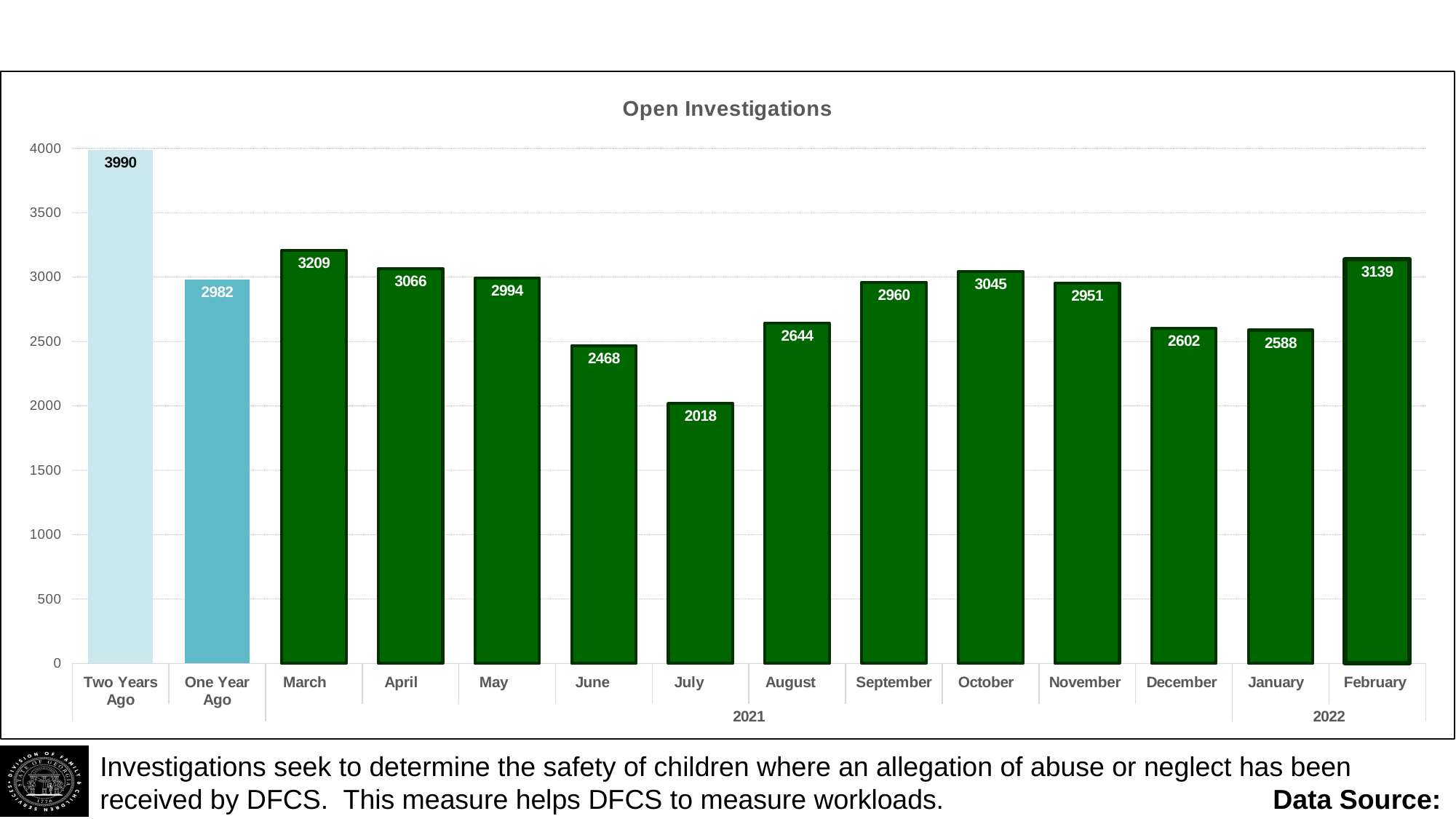
What is the value for February 2022? 3139 What is the title of the chart? Open Investigations Which is larger, the value for October or the value for November? October Which category has the highest value? Two Years Ago What kind of chart is shown on the slide? Bar chart How many bars are plotted in the chart? 14 What is the value for July 2021? 2018 Which month has the lowest value? July Do the values rise or fall from December 2021 to February 2022? Fall then rise Is the value for June 2021 greater or less than 2500? less What is the value for Two Years Ago? 3990 What is the difference between the values for March and July 2021? 1191